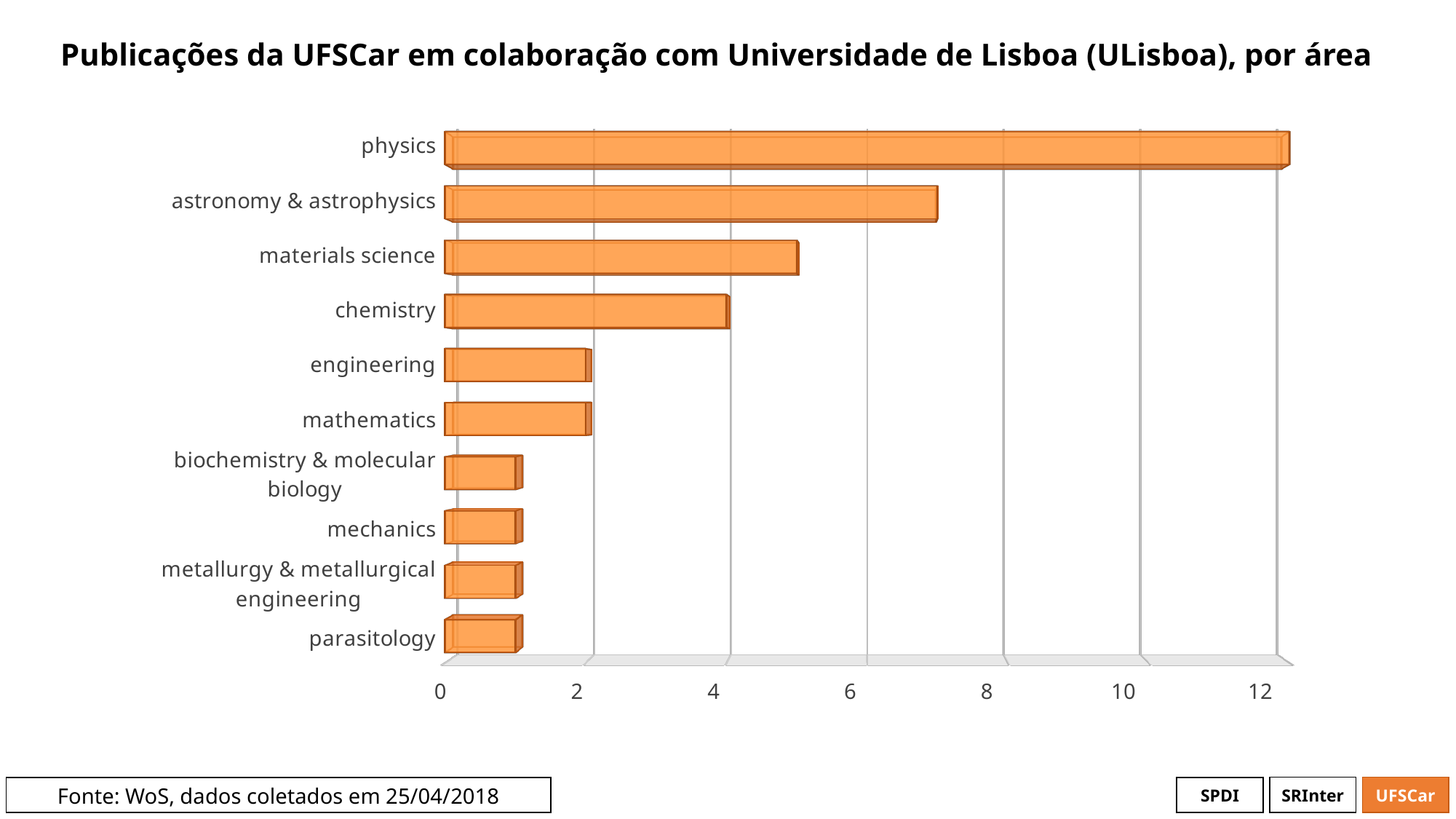
What is the value for physics? 12 Is the value for biochemistry & molecular biology greater or less than 2? less Is the value for astronomy & astrophysics greater or less than 6? greater What is the difference between the values for physics and chemistry? 8 What is the title of the chart? Publicações da UFSCar em colaboração com Universidade de Lisboa (ULisboa), por área What is the value for engineering? 2 What is the value for chemistry? 4 How many areas (categories) are shown in the chart? 10 Which area has the highest number of publications? physics What kind of chart is shown on the slide? bar chart Is the value for materials science greater or less than 6? less Which is larger, the value for astronomy & astrophysics or the value for materials science? astronomy & astrophysics